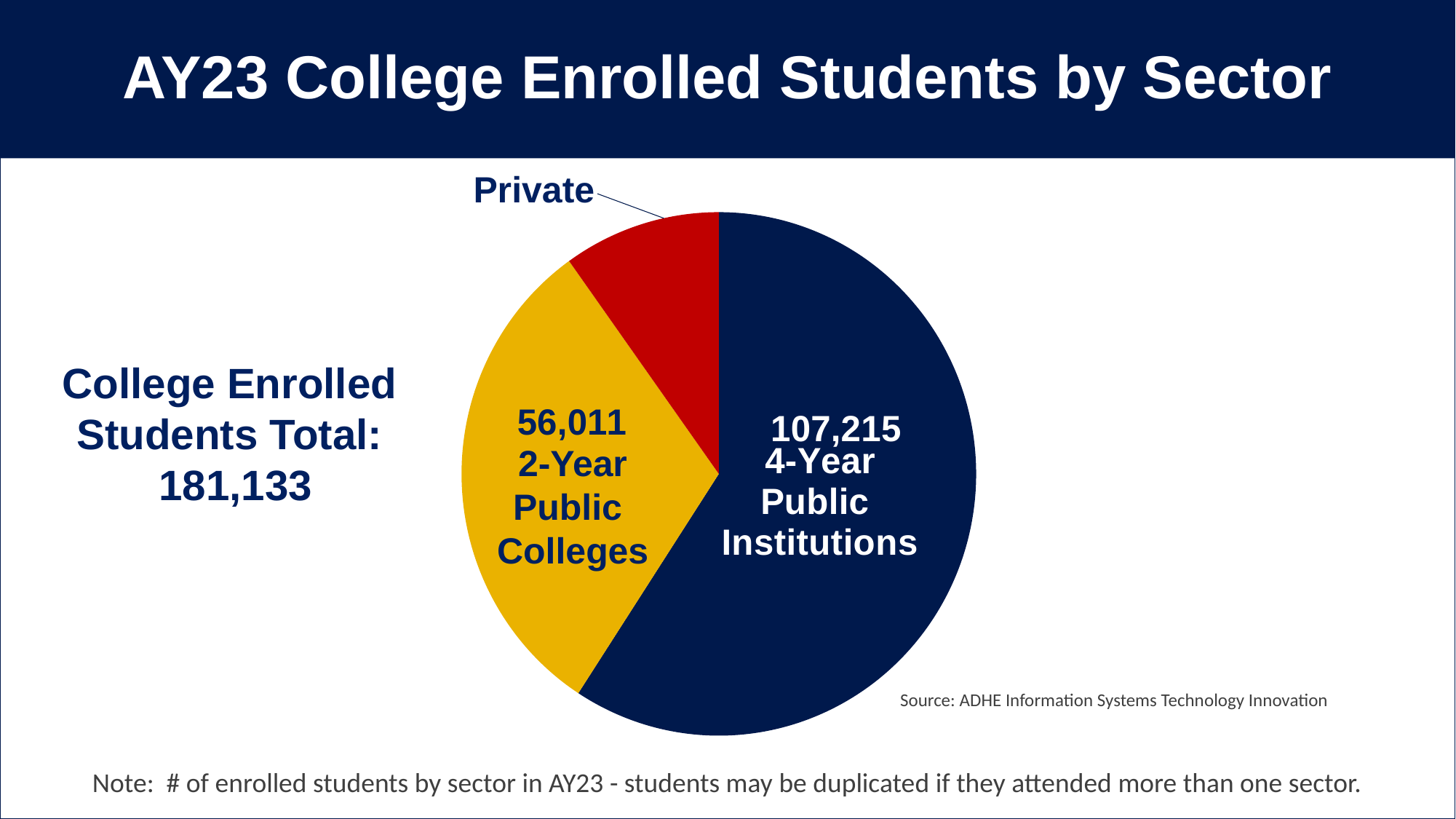
How many sectors (slices) does the pie chart show? 3 Which sector has more enrolled students, 4-Year Public Institutions or 2-Year Public Colleges? 4-Year Public Institutions Which sector has the largest number of enrolled students? 4-Year Public Institutions How many students were enrolled in 2-Year Public Colleges? 56,011 How many students were enrolled in 4-Year Public Institutions? 107,215 What kind of chart is shown on the slide? pie chart Which sector has the smallest slice of the pie? Private What is the title of the slide? AY23 College Enrolled Students by Sector What colour is the Private slice of the pie chart? red What is the difference in enrolled students between 4-Year Public Institutions and 2-Year Public Colleges? 51,204 What is the total number of college enrolled students shown on the slide? 181,133 Which sector has more enrolled students, 2-Year Public Colleges or Private? 2-Year Public Colleges